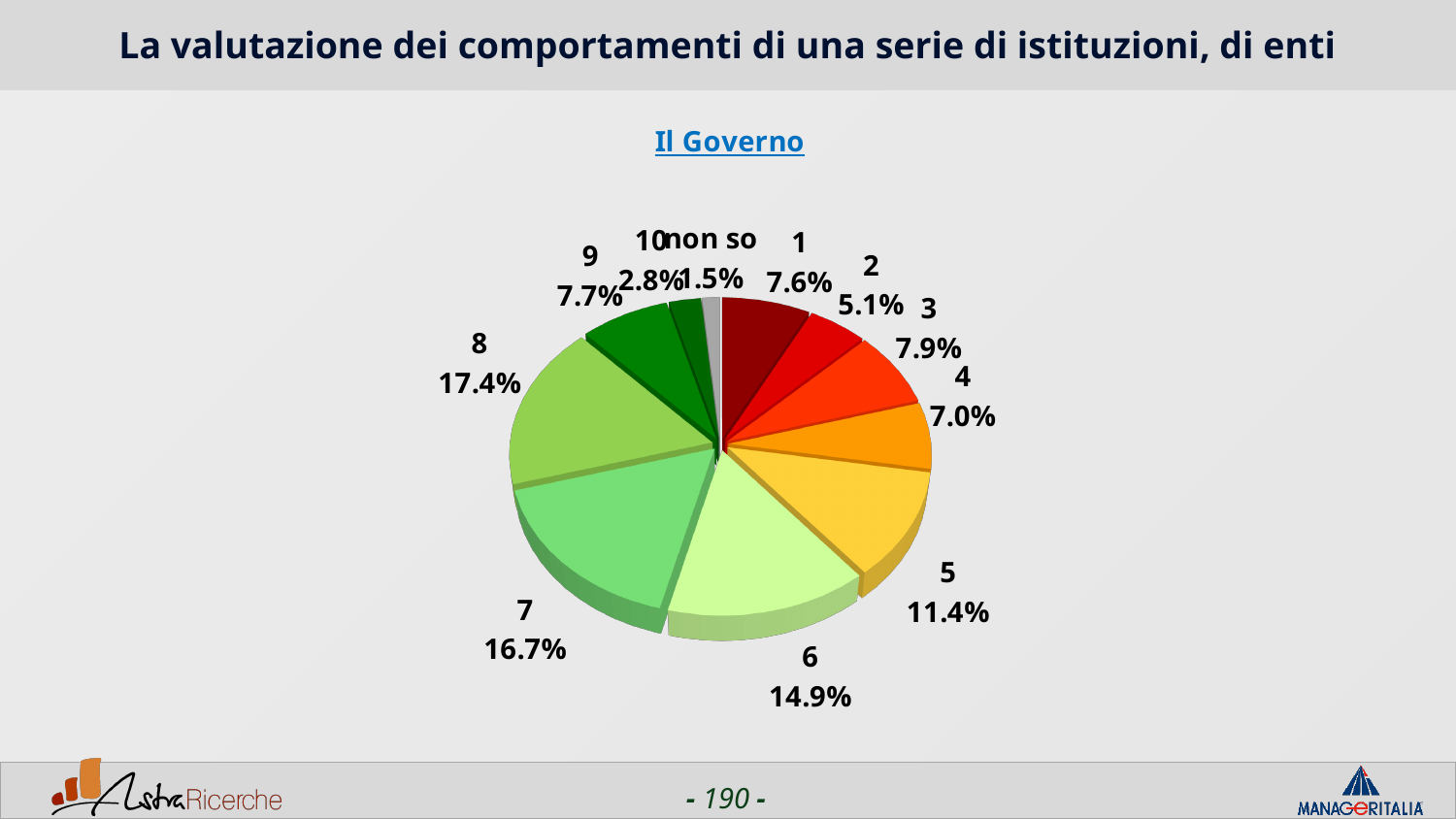
How many slices does the pie chart have? 11 Which category has the smallest share of the pie? non so What kind of chart is shown on the slide? pie chart What is the value for category 8? 17.4% Which is larger, the value for category 6 or the value for category 5? 6 What is the value for category 5? 11.4% Which category has the largest share of the pie? 8 What is the chart's title? Il Governo What is the combined share of categories 9 and 10? 10.5% What is the value for category 10? 2.8% What is the difference between the values for category 8 and category 7? 0.7% What is the value for 'non so'? 1.5%